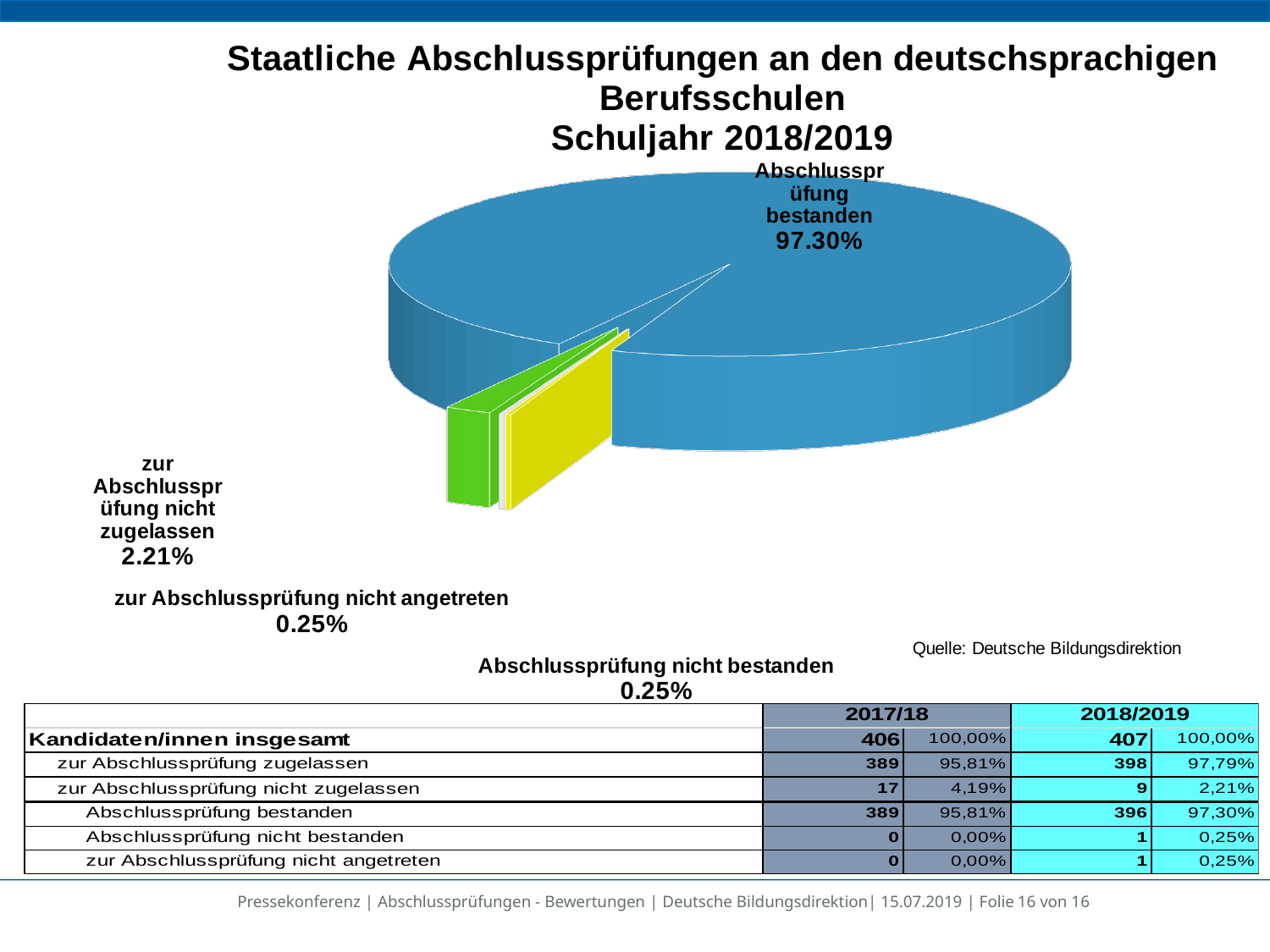
What colour is the largest slice of the pie chart? blue What kind of chart is shown on the slide? pie chart How many slices does the pie chart have? 4 What is the title of the chart? Staatliche Abschlussprüfungen an den deutschsprachigen Berufsschulen Schuljahr 2018/2019 What share of the pie does "Abschlussprüfung bestanden" represent? 97.30% Which is larger: the slice for "zur Abschlussprüfung nicht zugelassen" or the slice for "Abschlussprüfung nicht bestanden"? zur Abschlussprüfung nicht zugelassen What share of the pie does "zur Abschlussprüfung nicht zugelassen" represent? 2.21% What is the combined share of the "zur Abschlussprüfung nicht angetreten" and "Abschlussprüfung nicht bestanden" slices? 0.50% What is the difference in percentage points between the "Abschlussprüfung bestanden" slice and the "zur Abschlussprüfung nicht zugelassen" slice? 95.09 percentage points Which slice of the pie is the largest? Abschlussprüfung bestanden What share of the pie does "zur Abschlussprüfung nicht angetreten" represent? 0.25% What share of the pie does "Abschlussprüfung nicht bestanden" represent? 0.25%